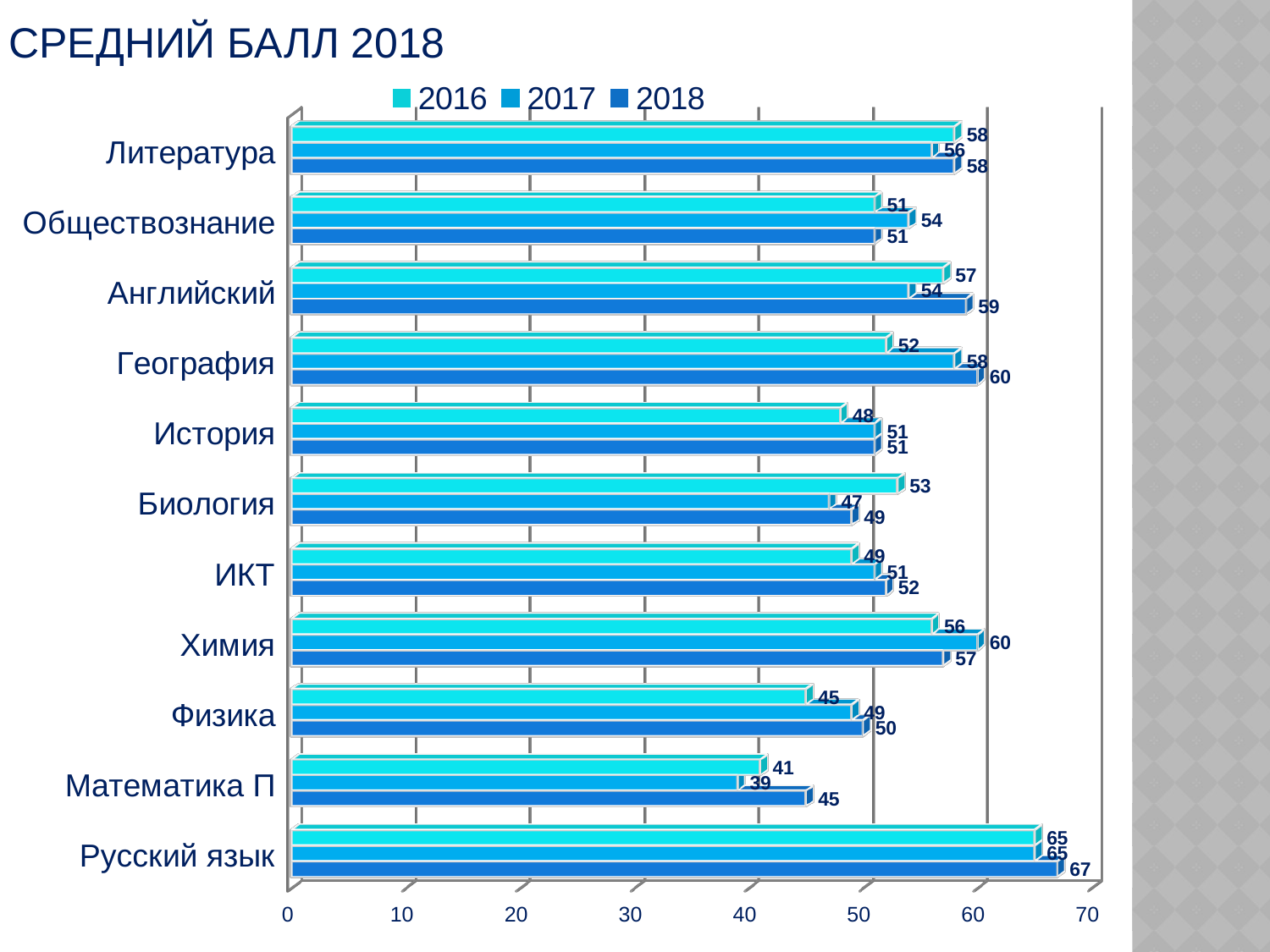
Which is larger for Биология: the 2016 value or the 2017 value? 2016 What is the difference between the 2018 and 2016 values for География? 8 Which category has the lowest 2017 value? Математика П What is the 2018 value for Русский язык? 67 What kind of chart is shown on the slide? Bar chart Which category has the highest 2018 value? Русский язык What is the 2016 value for Математика П? 41 How many categories are shown on the chart? 11 How many series does the legend list? 3 What is the title of the slide? СРЕДНИЙ БАЛЛ 2018 What is the difference between the 2018 and 2017 values for Математика П? 6 What is the 2017 value for Химия? 60